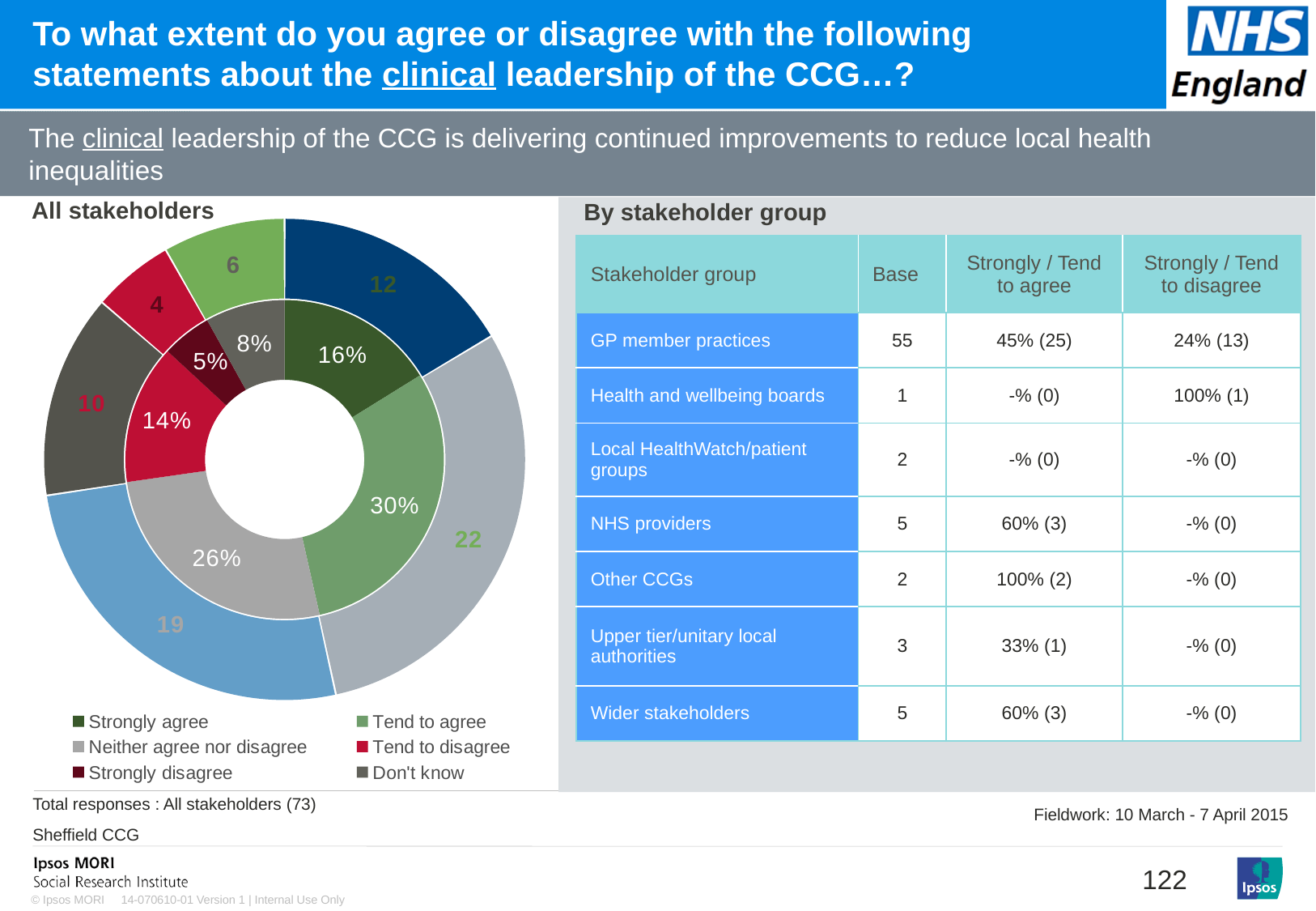
In the All stakeholders chart, what percentage of respondents "Neither agree nor disagree"? 26% In the All stakeholders chart, how many respondents (outer ring count) "Tend to agree"? 22 In the All stakeholders chart, which response category has the smallest share? Strongly disagree What kind of chart is shown under "All stakeholders"? Doughnut (pie) chart What is the total number of responses for the All stakeholders chart? 73 In the All stakeholders chart, which response category has the largest share? Tend to agree How many response categories does the legend of the All stakeholders chart list? 6 In the All stakeholders chart, what percentage of respondents "Strongly agree"? 16% In the All stakeholders chart, what percentage of respondents answered "Don't know"? 8% In the All stakeholders chart, what percentage of respondents "Tend to agree"? 30% In the All stakeholders chart, which is larger: "Neither agree nor disagree" or "Tend to disagree"? Neither agree nor disagree In the All stakeholders chart, what is the difference in percentage points between "Tend to agree" and "Strongly agree"? 14 percentage points